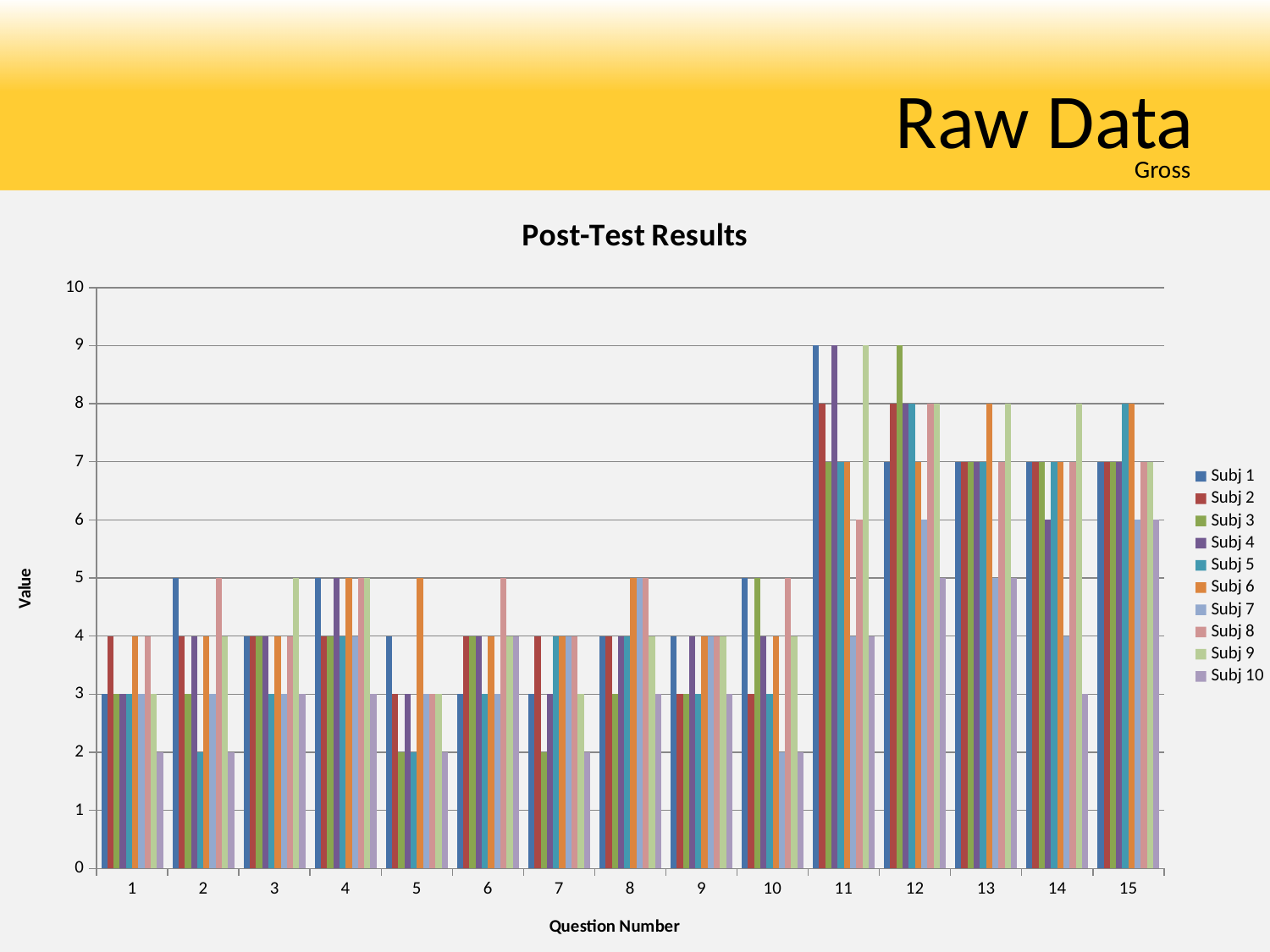
How many series does the legend list? 10 What is the title of the chart? Post-Test Results Which is larger for Subj 1: the value at question 2 or the value at question 1? Question 2 What is the value for Subj 1 at question number 1? 3 What is the value for Subj 6 at question number 5? 5 What type of chart is shown on the slide? Bar chart Is the value for Subj 1 at question 11 greater or less than 5? greater What is the difference between the value for Subj 1 at question 11 and at question 1? 6 What is the label on the x axis? Question Number How many question numbers are shown on the x axis? 15 What is the value for Subj 10 at question number 1? 2 What is the value for Subj 1 at question number 11? 9